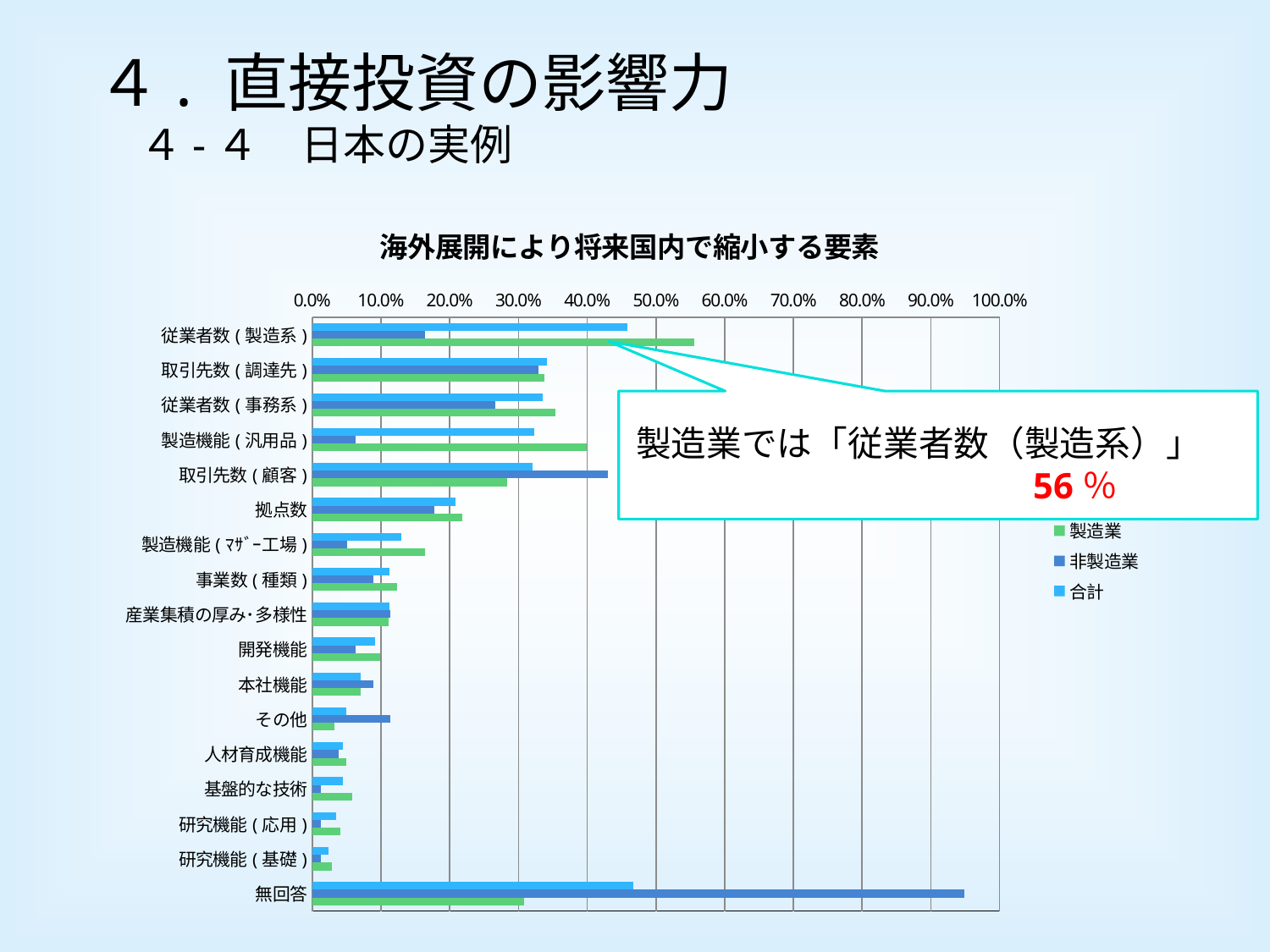
According to the callout, what is the 製造業 value for 従業者数(製造系)? 56% Is the 非製造業 value for 無回答 greater or less than 90.0%? greater Is the 合計 value for 従業者数(製造系) greater or less than 50.0%? less For 取引先数(顧客), which is larger: the 製造業 value or the 非製造業 value? 非製造業 Is the 非製造業 value for 製造機能(汎用品) greater or less than 10.0%? less How many series does the legend list? 3 Which category has the highest 非製造業 value? 無回答 How many categories are plotted on the vertical axis of the chart? 17 What is the title of the chart? 海外展開により将来国内で縮小する要素 What kind of chart is shown on the slide? bar chart Which colour represents the 製造業 series in the legend? green Which category has the highest 製造業 value? 従業者数(製造系)